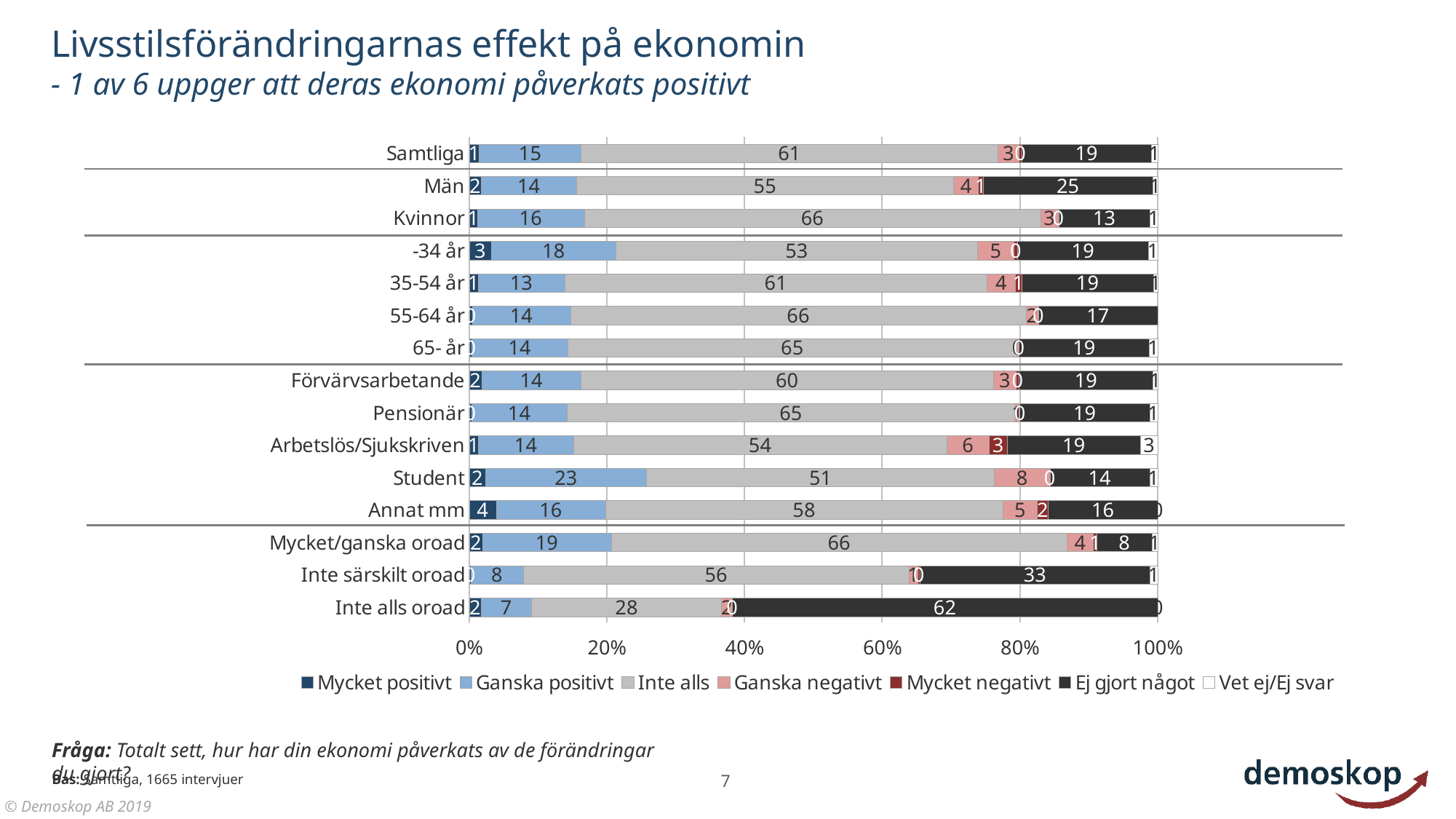
Which category has the highest value for "Ganska positivt"? Student How many series does the legend list? 7 What kind of chart is shown on the slide? Stacked bar chart How many categories are shown on the chart? 15 What is the value of "Inte alls" for Samtliga? 61 Which category has the lowest value for "Inte alls"? Inte alls oroad What is the value of "Ganska positivt" for Student? 23 What is the title of the slide? Livsstilsförändringarnas effekt på ekonomin What is the value of "Mycket positivt" for Annat mm? 4 What is the difference between the "Ej gjort något" values for Män and Kvinnor? 12 Which has a larger "Inte alls" value, Män or Kvinnor? Kvinnor What is the value of "Ej gjort något" for Inte alls oroad? 62